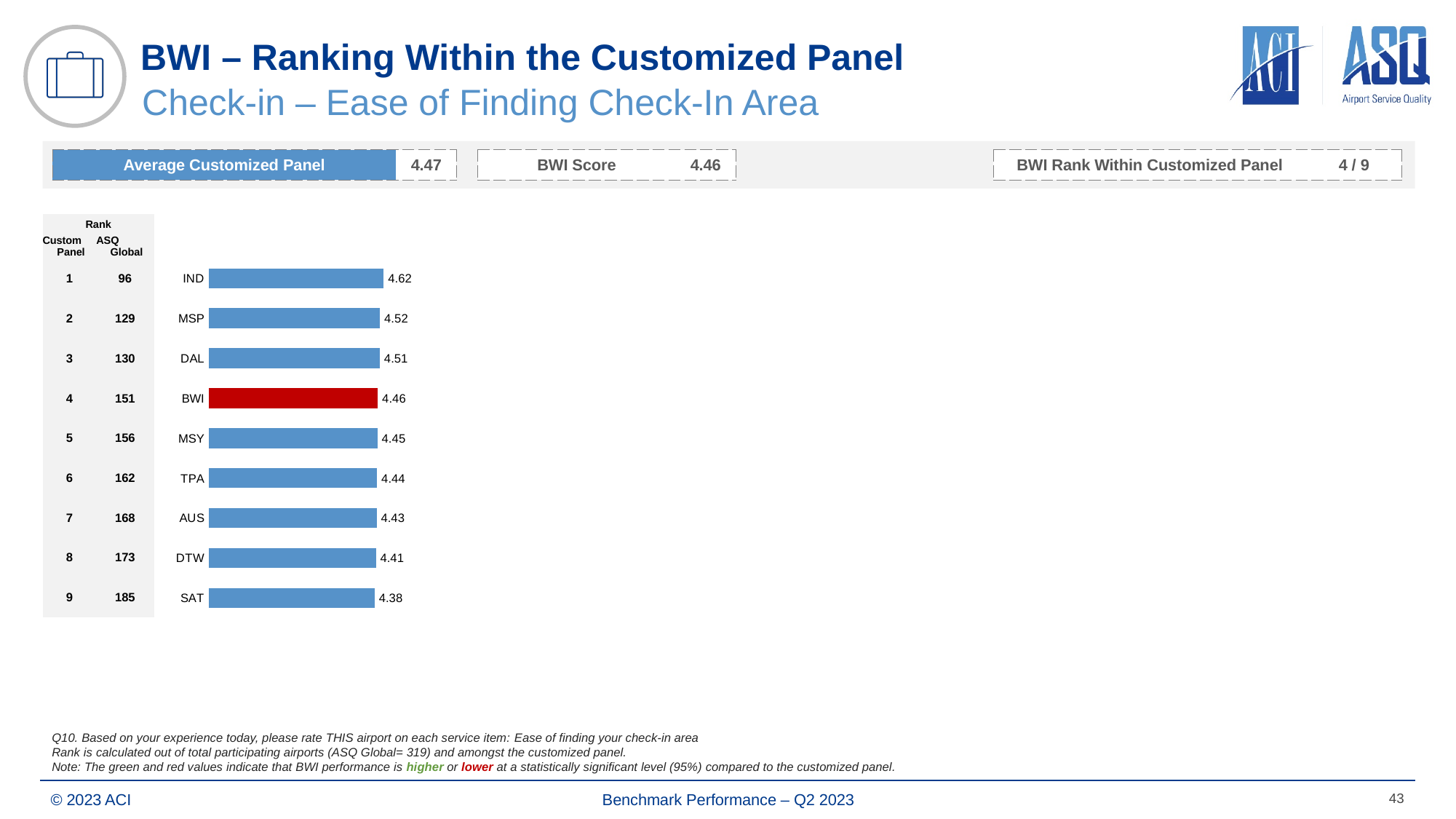
What is the ASQ Global rank shown for MSY? 156 What is the difference between the values for IND and SAT? 0.24 What is the difference between the values for MSP and BWI? 0.06 Which bar is coloured red? BWI Which airport has the highest value? IND What is the value for DTW? 4.41 What is the value for IND? 4.62 What kind of chart is shown on the slide? Bar chart What is the value for BWI? 4.46 How many airports are shown in the chart? 9 Which has a larger value, DAL or TPA? DAL Which airport has the lowest value? SAT